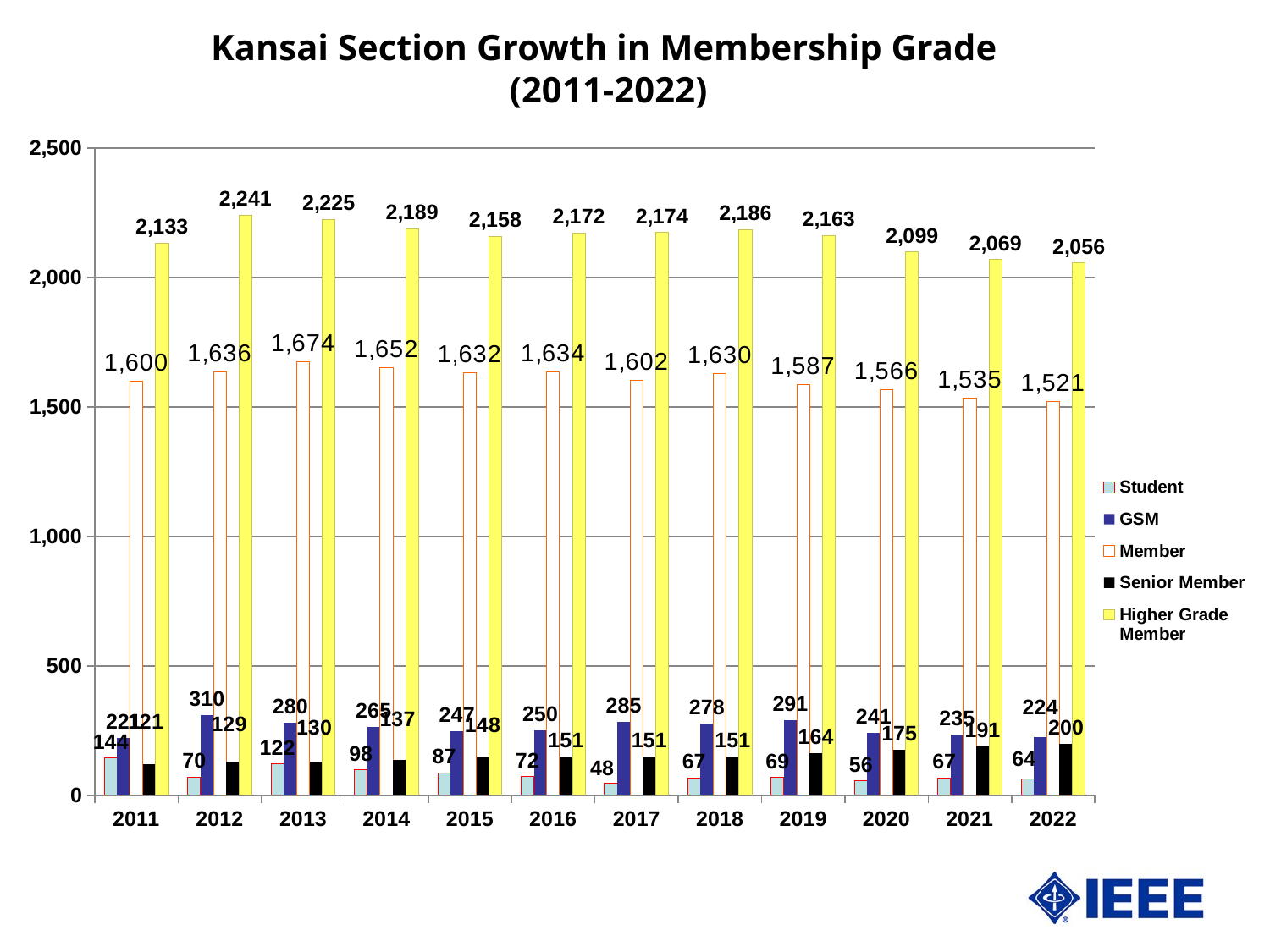
How many series does the legend list? 5 How many years are shown on the x axis? 12 Is the Member value for 2022 greater or less than 1,500? greater Which is larger, the GSM value in 2012 or in 2019? 2012 In which year is the Higher Grade Member value highest? 2012 In which year is the Student value lowest? 2017 What is the difference between the Member value in 2013 and in 2022? 153 What is the value for Member in 2013? 1,674 What is the value for Senior Member in 2022? 200 What kind of chart is shown on the slide? bar chart What is the value for Higher Grade Member in 2012? 2,241 Does the Senior Member value rise or fall from 2011 to 2022? rise